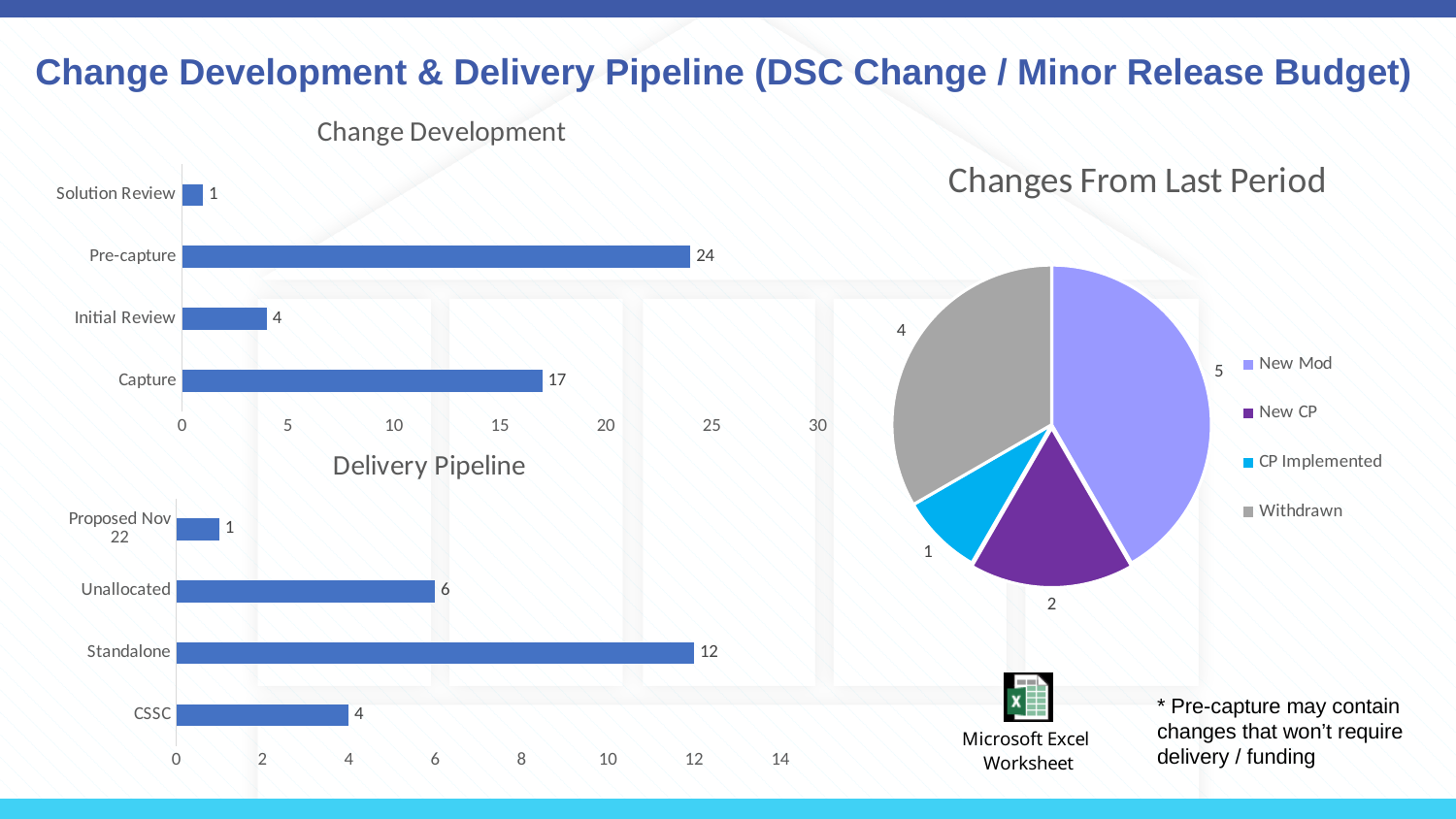
In the Change Development chart, which category has the lowest value? Solution Review In the Delivery Pipeline chart, which is larger, Unallocated or CSSC? Unallocated In the Change Development chart, what is the value for Pre-capture? 24 In the Change Development chart, what is the difference between Pre-capture and Capture? 7 In the Delivery Pipeline chart, what is the value for Proposed Nov 22? 1 In the Delivery Pipeline chart, which category has the highest value? Standalone In the Delivery Pipeline chart, what is the value for Standalone? 12 How many entries does the legend of the Changes From Last Period pie chart list? 4 In the Changes From Last Period pie chart, what is the value for Withdrawn? 4 In the Change Development chart, how many categories are shown? 4 What kind of chart is the Delivery Pipeline chart? Bar chart In the Changes From Last Period pie chart, which category has the largest slice? New Mod